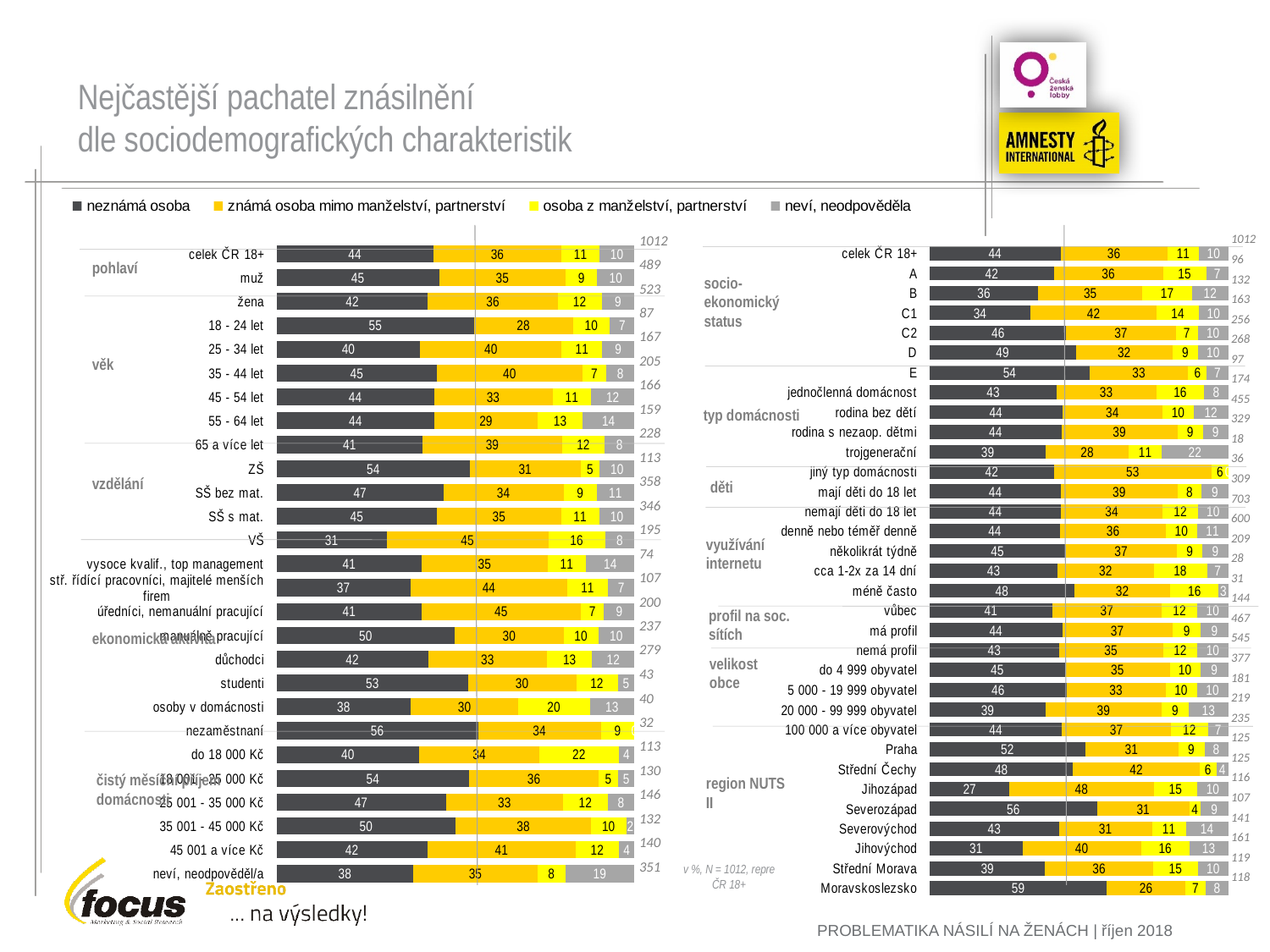
In the right chart, what is the 'neznámá osoba' value for Jihozápad? 27 What colour represents 'neznámá osoba' in the legend? Dark grey How many series does the legend at the top of the slide list? 4 In the right chart, what is the 'neznámá osoba' value for Moravskoslezsko? 59 In the right chart, which region NUTS II has the lowest 'neznámá osoba' value? Jihozápad In the left chart, for the 'VŠ' row, what is the difference between the 'známá osoba mimo manželství, partnerství' value and the 'neznámá osoba' value? 14 What kind of chart is used on this slide? Stacked bar chart In the left chart, what is the value for 'známá osoba mimo manželství, partnerství' in the '18 - 24 let' row? 28 In the right chart, which region NUTS II has the highest 'neznámá osoba' value? Moravskoslezsko In the right chart, what is the 'osoba z manželství, partnerství' value for socio-economic status B? 17 In the left chart, which has the higher 'neznámá osoba' value, muž or žena? muž In the left chart, what percentage of respondents in the 'celek ČR 18+' row answered 'neznámá osoba'? 44